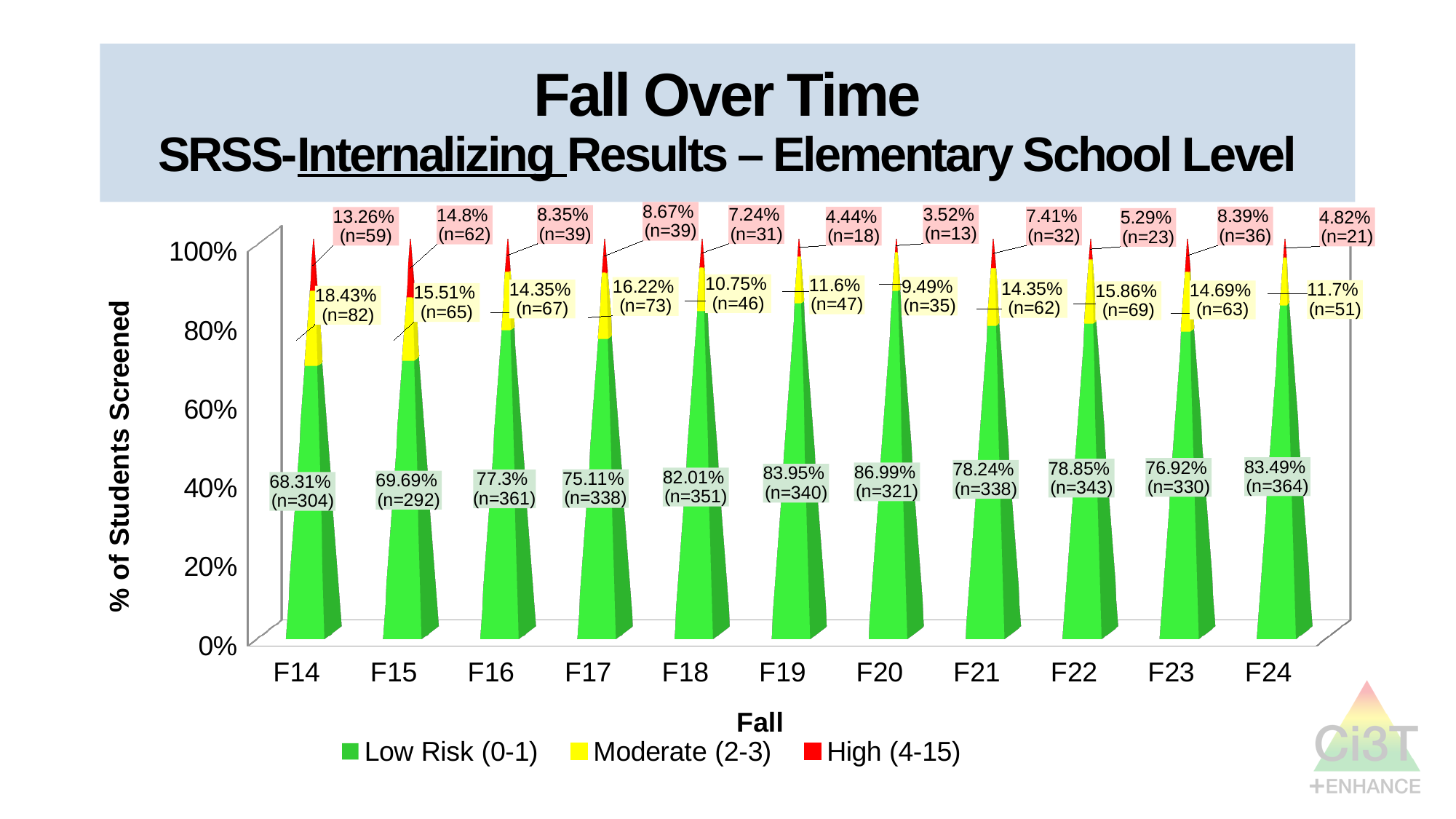
Which fall has the highest High (4-15) percentage? F15 What kind of chart is shown on the slide? Stacked bar chart What is the difference between the Low Risk (0-1) percentage in F20 and in F14? 18.68% What percentage of students were in the High (4-15) category in F14? 13.26% How many students were in the Moderate (2-3) category in F17? n=73 How many fall semesters are shown on the x axis? 11 Which has a larger Low Risk (0-1) percentage, F18 or F19? F19 What percentage of students were Moderate (2-3) in F24? 11.7% How many series does the legend list? 3 Which fall has the lowest Low Risk (0-1) percentage? F14 Which fall has the highest Low Risk (0-1) percentage? F20 What percentage of students were Low Risk (0-1) in F20? 86.99%